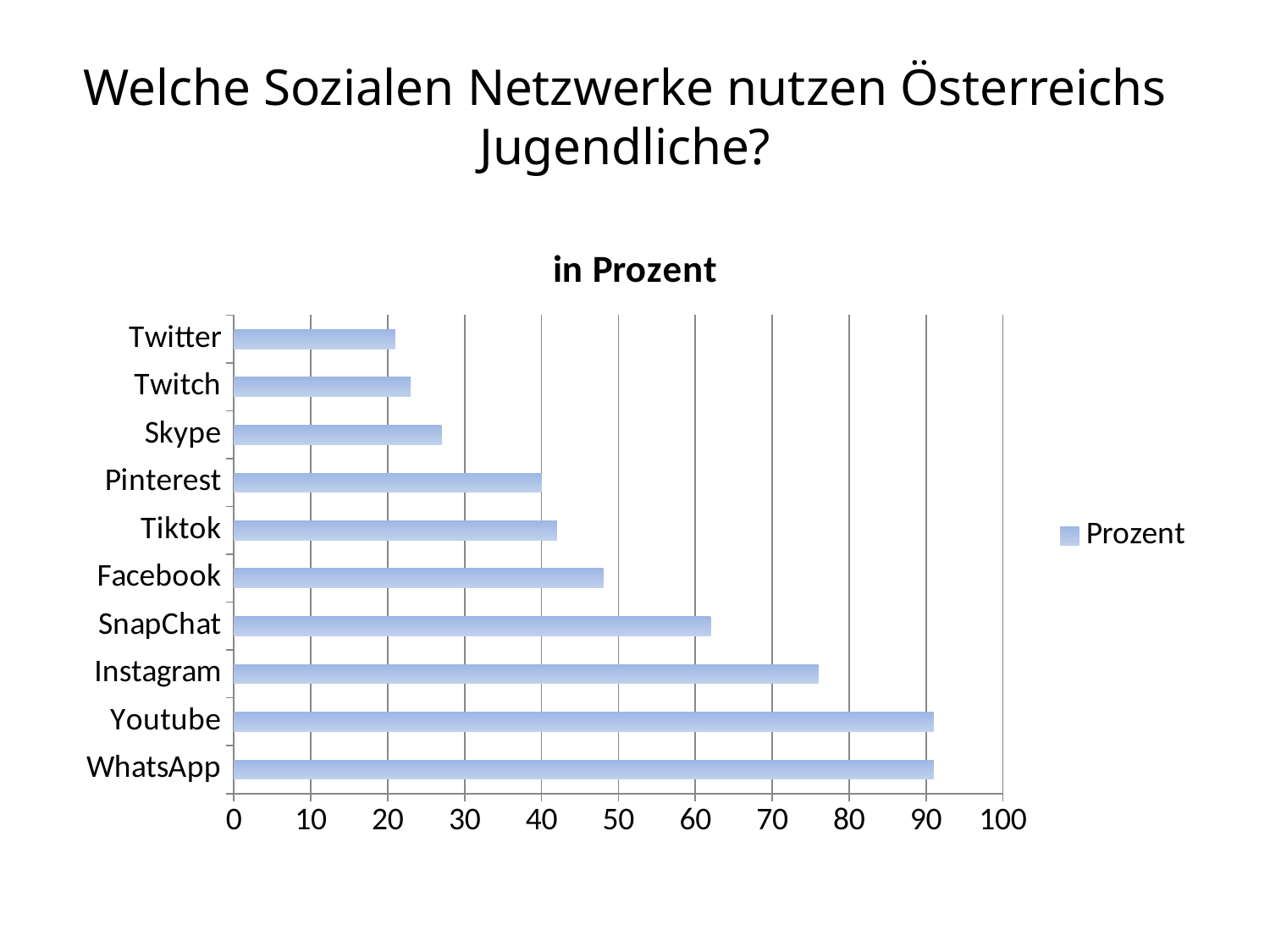
Which has a higher value, Skype or SnapChat? SnapChat Is the value for Twitter greater or less than 30? less Is the value for Youtube greater or less than 80? greater Is the value for SnapChat greater or less than 70? less What is the name of the series shown in the legend? Prozent What is the title of the chart? in Prozent How many social networks are listed on the chart? 10 What kind of chart is shown on the slide? bar chart Which has a higher value, Instagram or Facebook? Instagram How many series does the legend list? 1